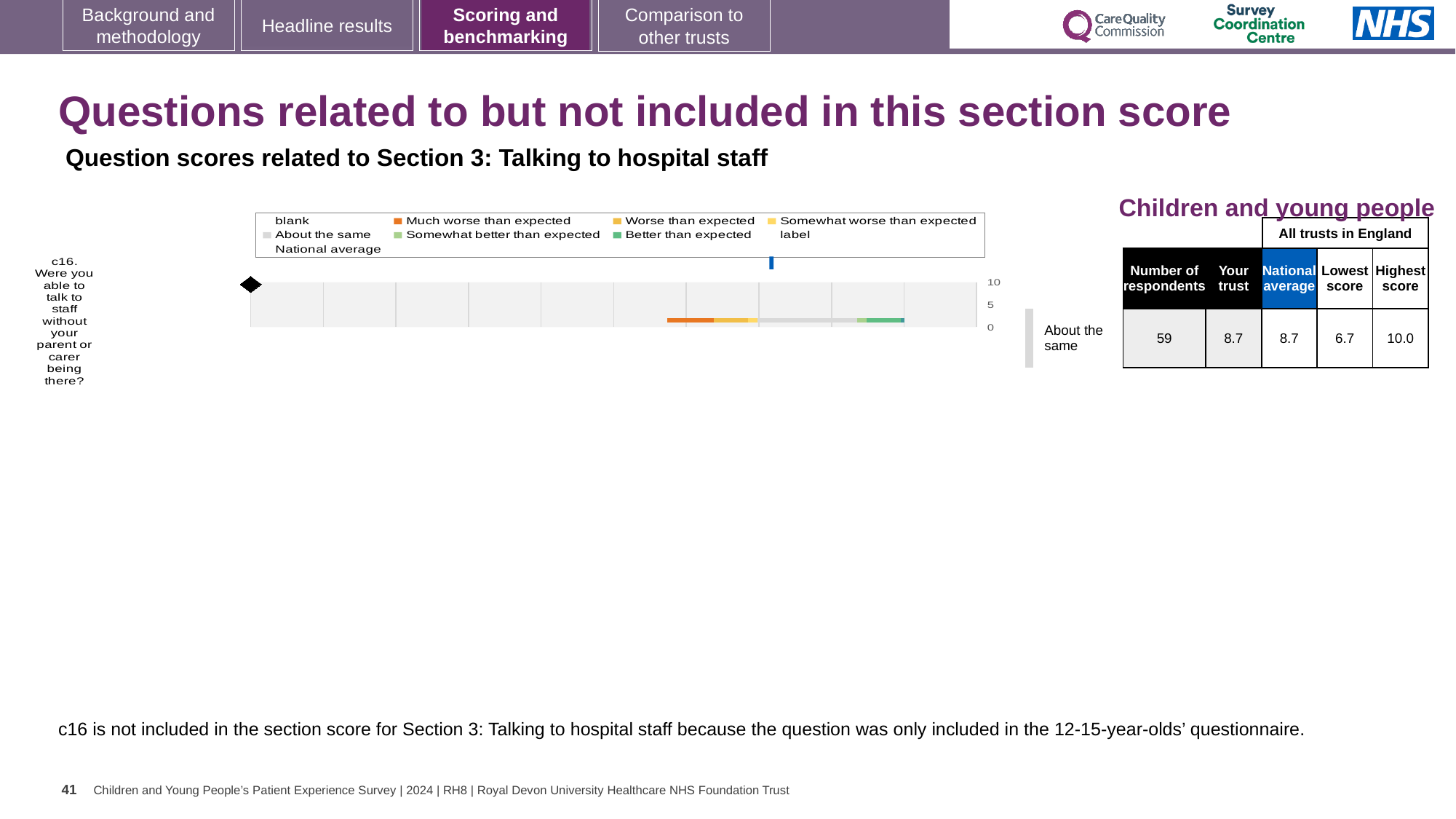
What is the difference between the highest score and the lowest score for c16? 3.3 How many survey questions are plotted in the chart? 1 How many respondents answered c16? 59 What kind of chart is used to show the c16 benchmarking result? bar chart What benchmark category is shown for c16 next to the chart? About the same How many legend entries contain the word 'expected'? 5 What is the 'Your trust' score for c16 in the table beside the chart? 8.7 What colour does the legend use for 'Much worse than expected'? orange Which question code is plotted in the chart? c16 What is the national average score for c16 in the table beside the chart? 8.7 What is the highest score across all trusts in England for c16? 10.0 What is the lowest score across all trusts in England for c16? 6.7